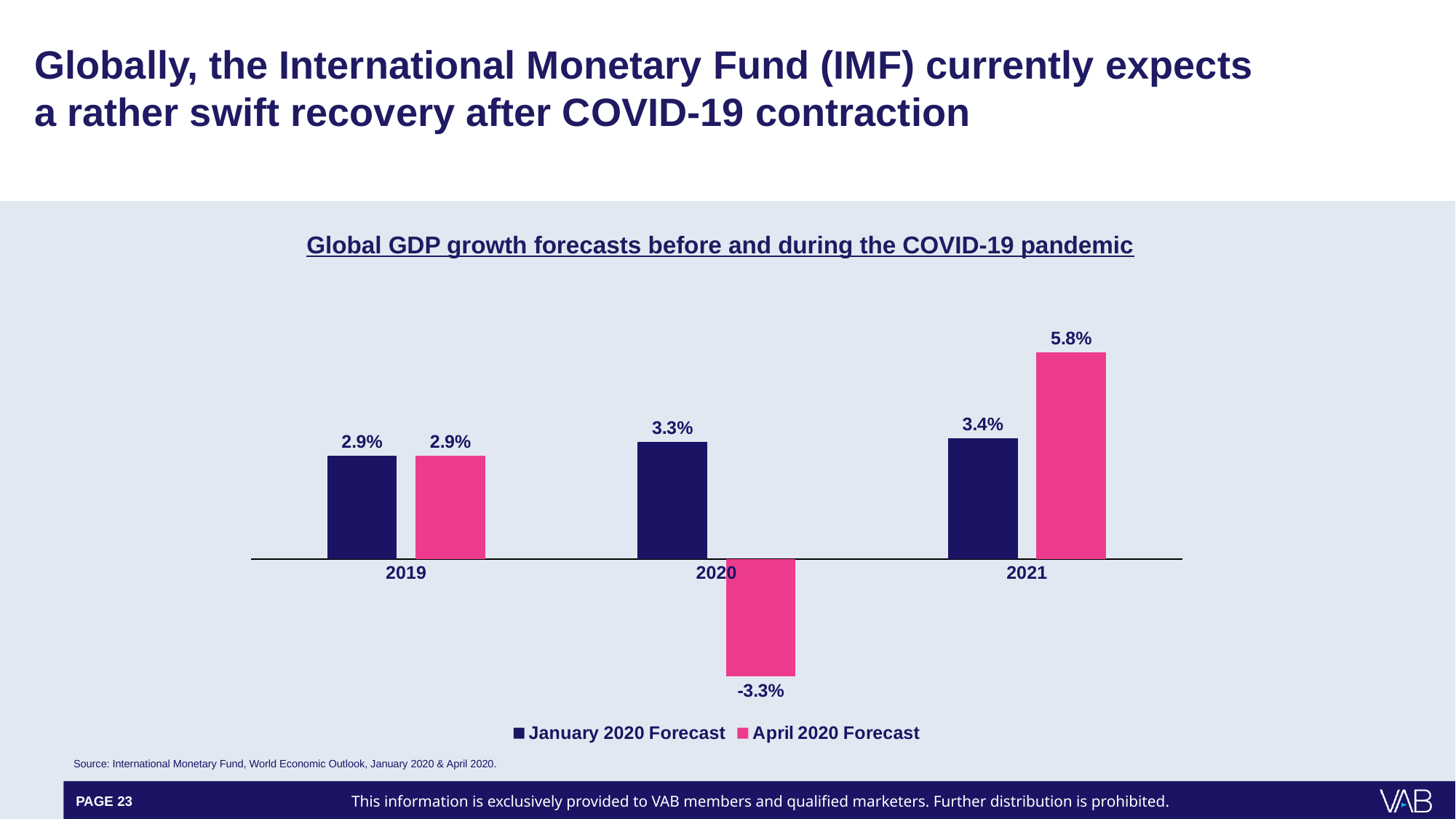
Which year has the highest April 2020 Forecast value? 2021 What is the January 2020 Forecast value for 2019? 2.9% What is the April 2020 Forecast value for 2021? 5.8% What is the January 2020 Forecast value for 2021? 3.4% What kind of chart is shown on the slide? Bar chart Which is larger for 2020: the January 2020 Forecast or the April 2020 Forecast? January 2020 Forecast Which year has the lowest April 2020 Forecast value? 2020 What is the difference between the January 2020 Forecast and the April 2020 Forecast for 2020? 6.6% How many years are shown on the x axis? 3 What is the April 2020 Forecast value for 2020? -3.3% What is the difference between the April 2020 Forecast and the January 2020 Forecast for 2021? 2.4% How many series does the legend list? 2